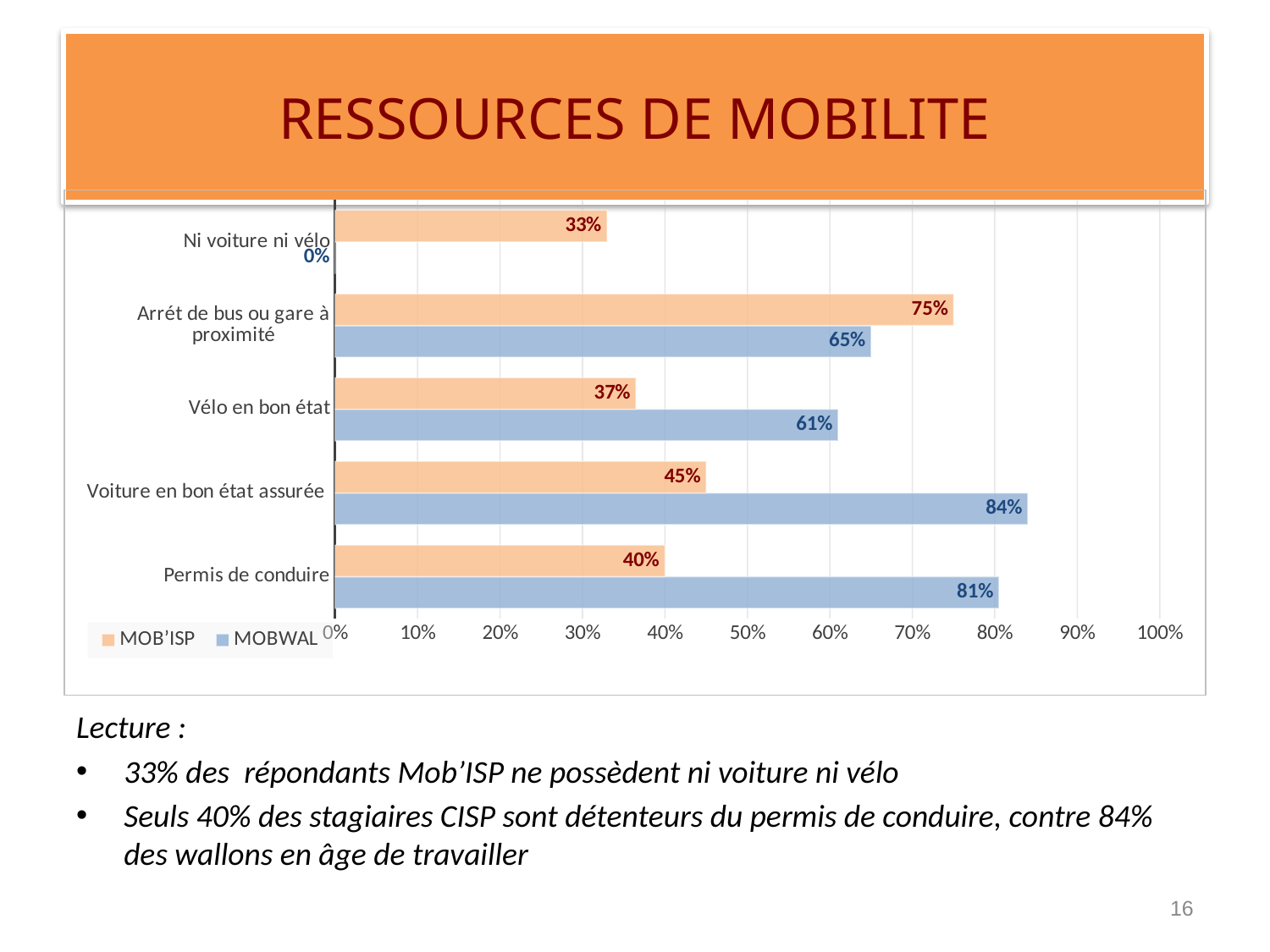
How many categories are shown on the chart? 5 What is the MOB'ISP value for "Permis de conduire"? 40% Which category has the highest MOB'ISP value? Arrêt de bus ou gare à proximité Which category has the lowest MOBWAL value? Ni voiture ni vélo What is the difference between the MOBWAL and MOB'ISP values for "Permis de conduire"? 41% Which colour represents the MOBWAL series? Blue How many series does the legend list? 2 What is the MOB'ISP value for "Ni voiture ni vélo"? 33% What kind of chart is shown on the slide? Bar chart What is the MOBWAL value for "Voiture en bon état assurée"? 84% For "Arrêt de bus ou gare à proximité", which series has the larger value, MOB'ISP or MOBWAL? MOB'ISP What is the MOBWAL value for "Vélo en bon état"? 61%